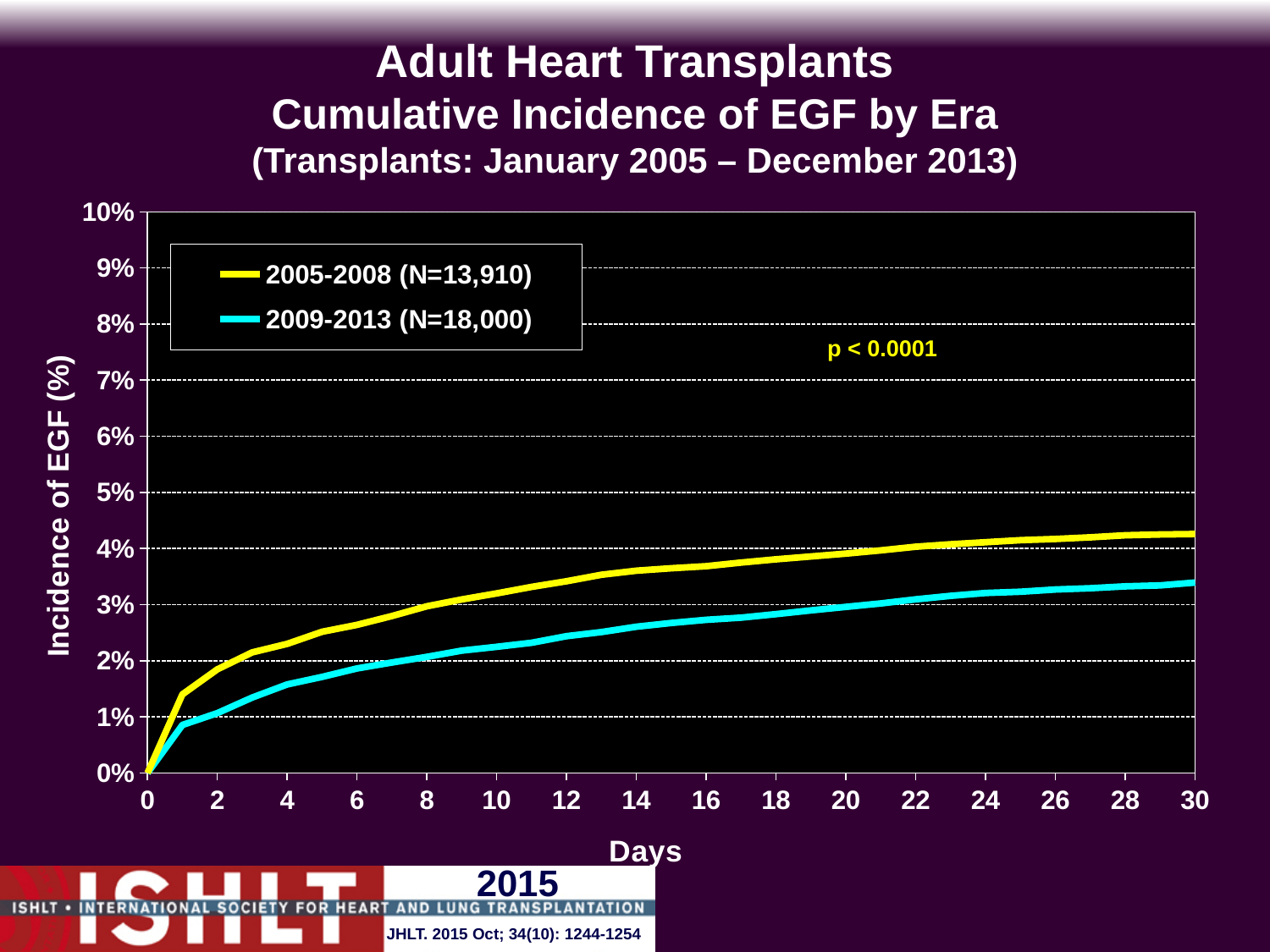
What kind of chart is shown on the slide? line chart Which era has the higher cumulative incidence of EGF at day 30, 2005-2008 or 2009-2013? 2005-2008 What is the N shown in the legend for the 2009-2013 era? N=18,000 Is the value for 2005-2008 at day 30 greater or less than 4%? greater Is the value for 2009-2013 at day 30 greater or less than 4%? less What p-value is printed on the chart? p < 0.0001 Is the value for 2009-2013 at day 4 greater or less than 2%? less Which era's line is lower across the whole 30-day period? 2009-2013 Do the cumulative incidence values rise or fall as days increase? rise How many series does the legend list? 2